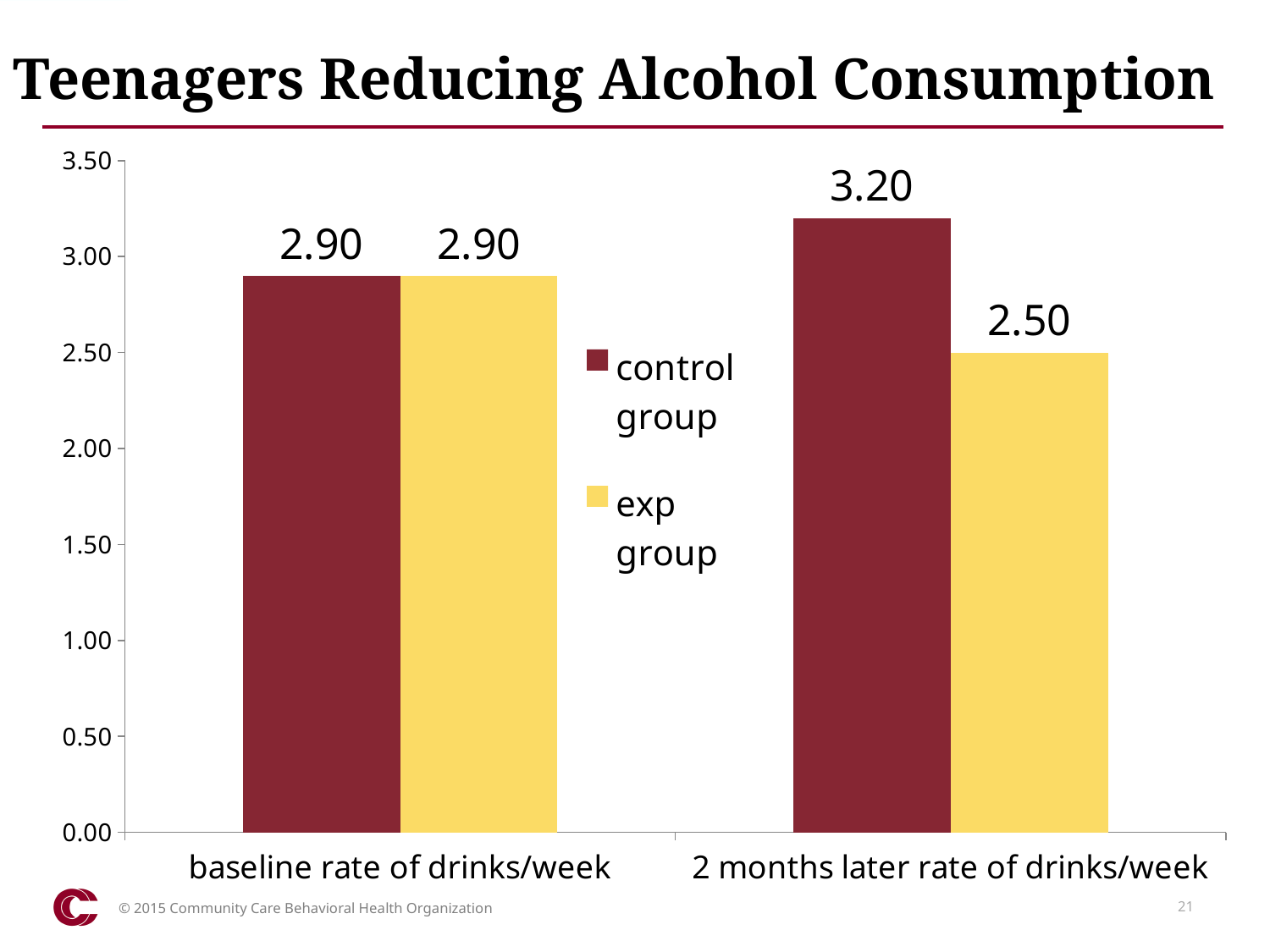
How many categories are shown on the x axis? 2 Is the value for the exp group at 2 months later rate of drinks/week greater or less than 3.00? less What is the difference between the control group and the exp group at 2 months later rate of drinks/week? 0.70 What is the value for the control group at baseline rate of drinks/week? 2.90 Is the control group's value at 2 months later larger or smaller than its value at baseline? larger What is the value for the exp group at 2 months later rate of drinks/week? 2.50 What is the value for the control group at 2 months later rate of drinks/week? 3.20 Which bar has the lowest value on the chart? exp group at 2 months later rate of drinks/week Which series has the highest value at 2 months later rate of drinks/week? control group By how much did the exp group's value change from baseline to 2 months later? 0.40 What kind of chart is shown on the slide? bar chart How many series does the legend list? 2